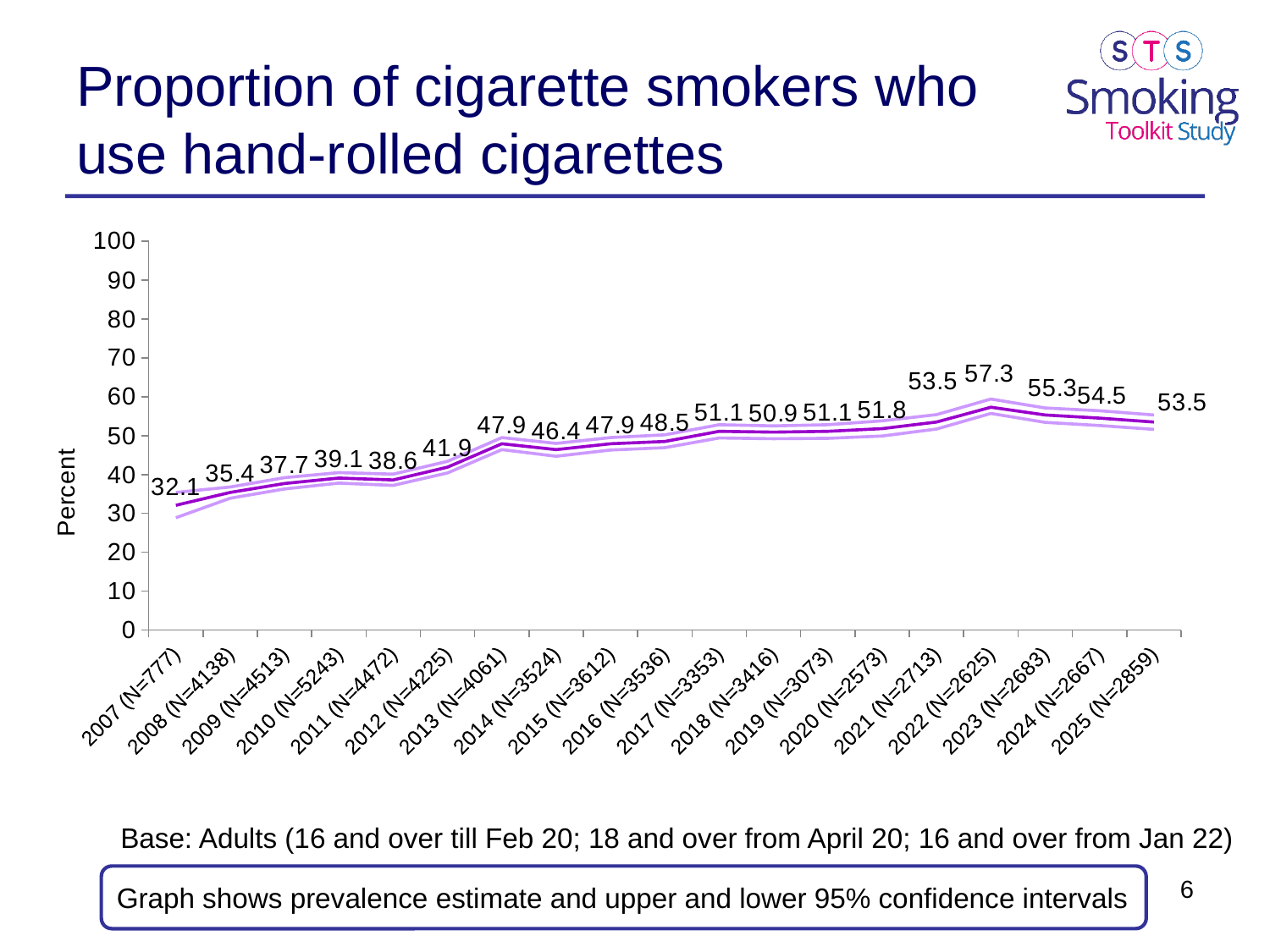
Which is larger, the value for 2013 (N=4061) or the value for 2014 (N=3524)? 2013 (N=4061) What is the label of the y axis? Percent How many years are plotted on the x axis? 19 What is the value for 2014 (N=3524)? 46.4 What is the value for 2007 (N=777)? 32.1 Do the values generally rise or fall from 2007 to 2022? Rise What kind of chart is shown? Line chart What is the value for 2022 (N=2625)? 57.3 Which year has the highest value? 2022 (N=2625) Which year has the lowest value? 2007 (N=777) What is the difference between the values for 2022 (N=2625) and 2007 (N=777)? 25.2 What is the value for 2025 (N=2859)? 53.5